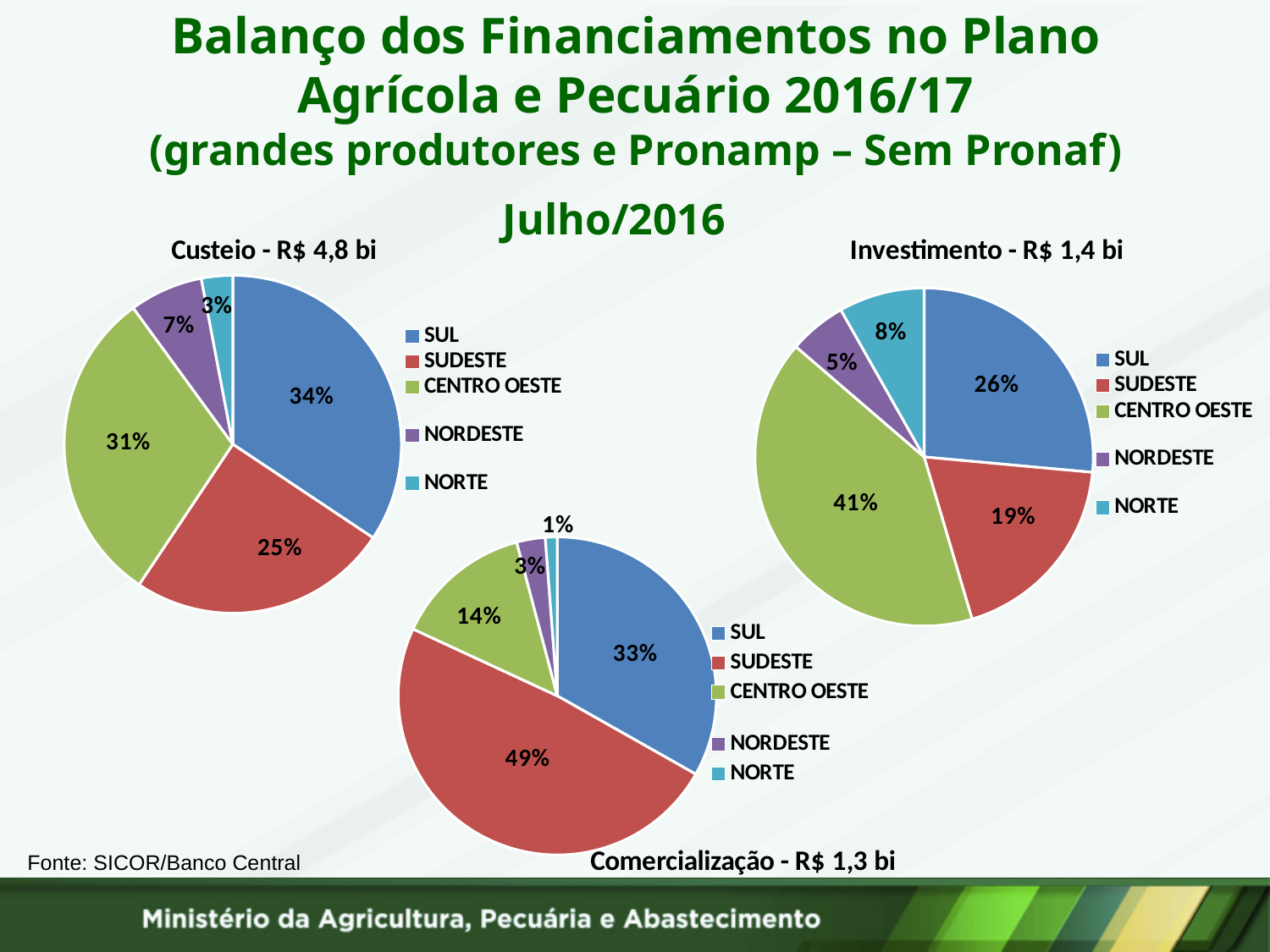
In the Comercialização - R$ 1,3 bi chart, what is the difference in percentage points between SUDESTE and SUL? 16 percentage points In the Custeio - R$ 4,8 bi chart, what share does SUL have? 34% In the Custeio - R$ 4,8 bi chart, which region has the smallest share? NORTE In the Comercialização - R$ 1,3 bi chart, what share does NORTE have? 1% In the Custeio - R$ 4,8 bi chart, which is larger, the share of SUDESTE or the share of CENTRO OESTE? CENTRO OESTE What type of chart is the Comercialização - R$ 1,3 bi chart? Pie chart In the Comercialização - R$ 1,3 bi chart, which region has the largest share? SUDESTE In the Investimento - R$ 1,4 bi chart, what share does SUDESTE have? 19% How many regions does the legend of the Investimento - R$ 1,4 bi chart list? 5 In the Investimento - R$ 1,4 bi chart, which region has the smallest share? NORDESTE In the Custeio - R$ 4,8 bi chart, what share does CENTRO OESTE have? 31% In the Investimento - R$ 1,4 bi chart, which region has the largest share? CENTRO OESTE